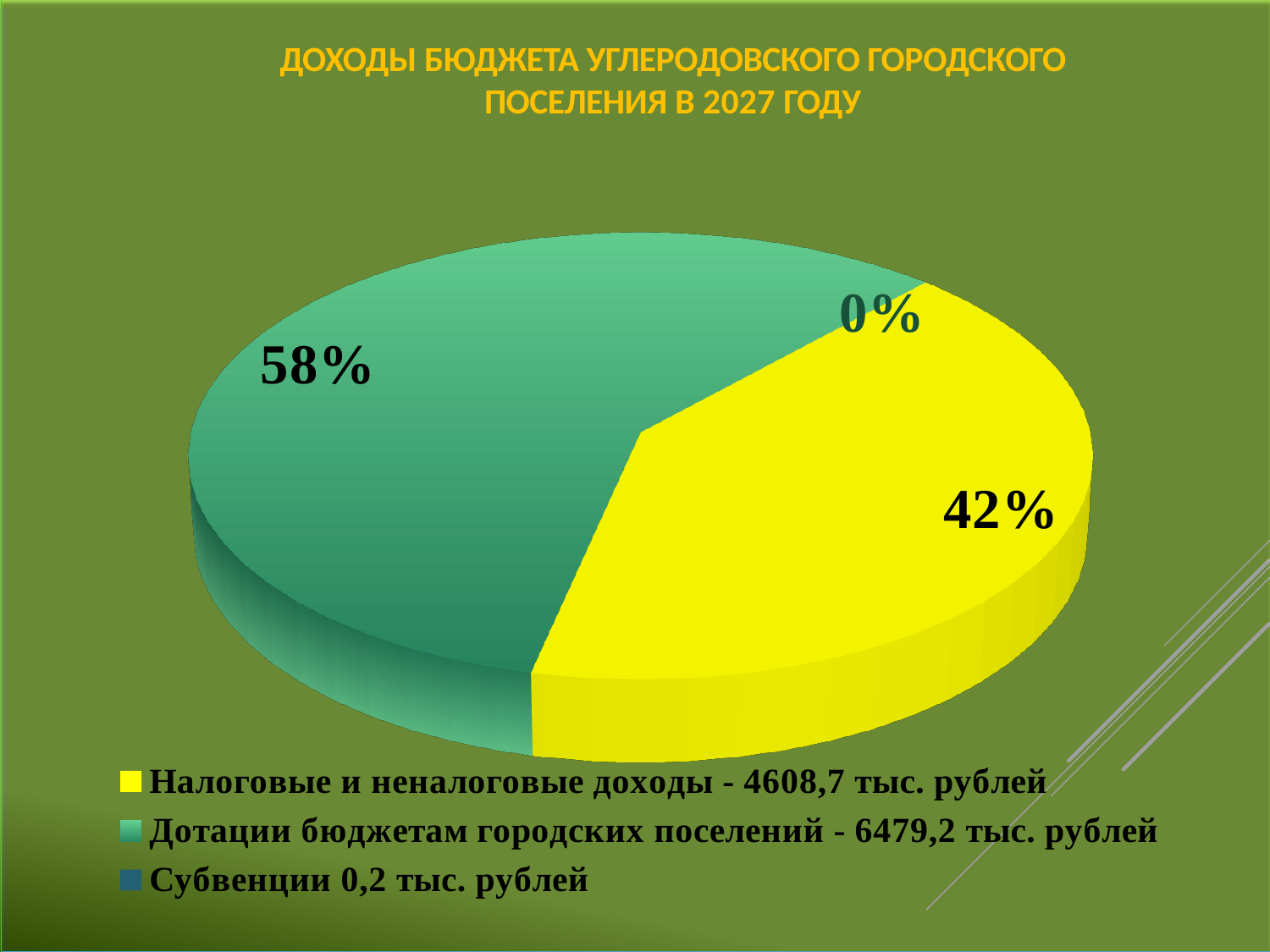
Which category has the smallest slice of the pie? Субвенции What colour is the slice for "Налоговые и неналоговые доходы"? yellow What kind of chart is shown on the slide? pie chart What share of the pie does "Дотации бюджетам городских поселений" take? 58% How many categories does the legend list? 3 Which category has the largest slice of the pie? Дотации бюджетам городских поселений Which is larger: the slice for "Налоговые и неналоговые доходы" or the slice for "Дотации бюджетам городских поселений"? Дотации бюджетам городских поселений What amount in thousand rubles does the legend give for "Субвенции"? 0,2 тыс. рублей What share of the pie does "Субвенции" take? 0% What share of the pie does "Налоговые и неналоговые доходы" take? 42% What is the difference in percentage points between the "Дотации бюджетам городских поселений" slice and the "Налоговые и неналоговые доходы" slice? 16 What amount in thousand rubles does the legend give for "Налоговые и неналоговые доходы"? 4608,7 тыс. рублей